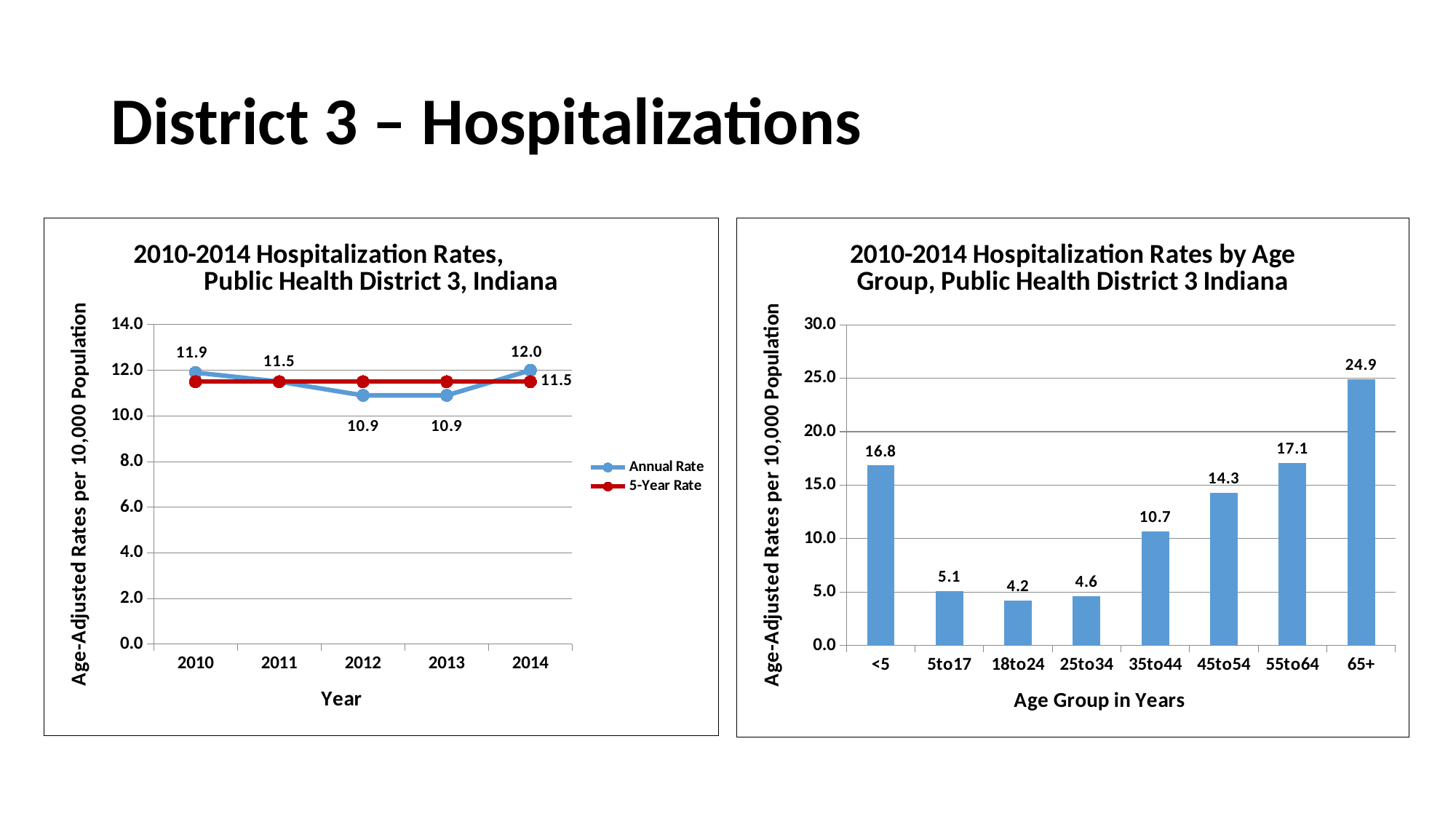
In the left chart, what is the 5-Year Rate? 11.5 In the right chart, how many age groups are shown? 8 In the left chart, what is the difference between the Annual Rate in 2014 and the Annual Rate in 2013? 1.1 In the right chart, what is the rate for the 45to54 age group? 14.3 In the right chart, which age group has the lowest rate? 18to24 In the right chart (2010-2014 Hospitalization Rates by Age Group), which age group has the highest rate? 65+ In the left chart (2010-2014 Hospitalization Rates, Public Health District 3, Indiana), what is the Annual Rate for 2012? 10.9 In the left chart, what is the Annual Rate for 2014? 12.0 In the right chart, what is the difference between the rate for 65+ and the rate for 35to44? 14.2 In the left chart, how many series does the legend list? 2 In the left chart, what type of chart is shown? Line chart In the right chart, which is larger, the rate for <5 or the rate for 55to64? 55to64